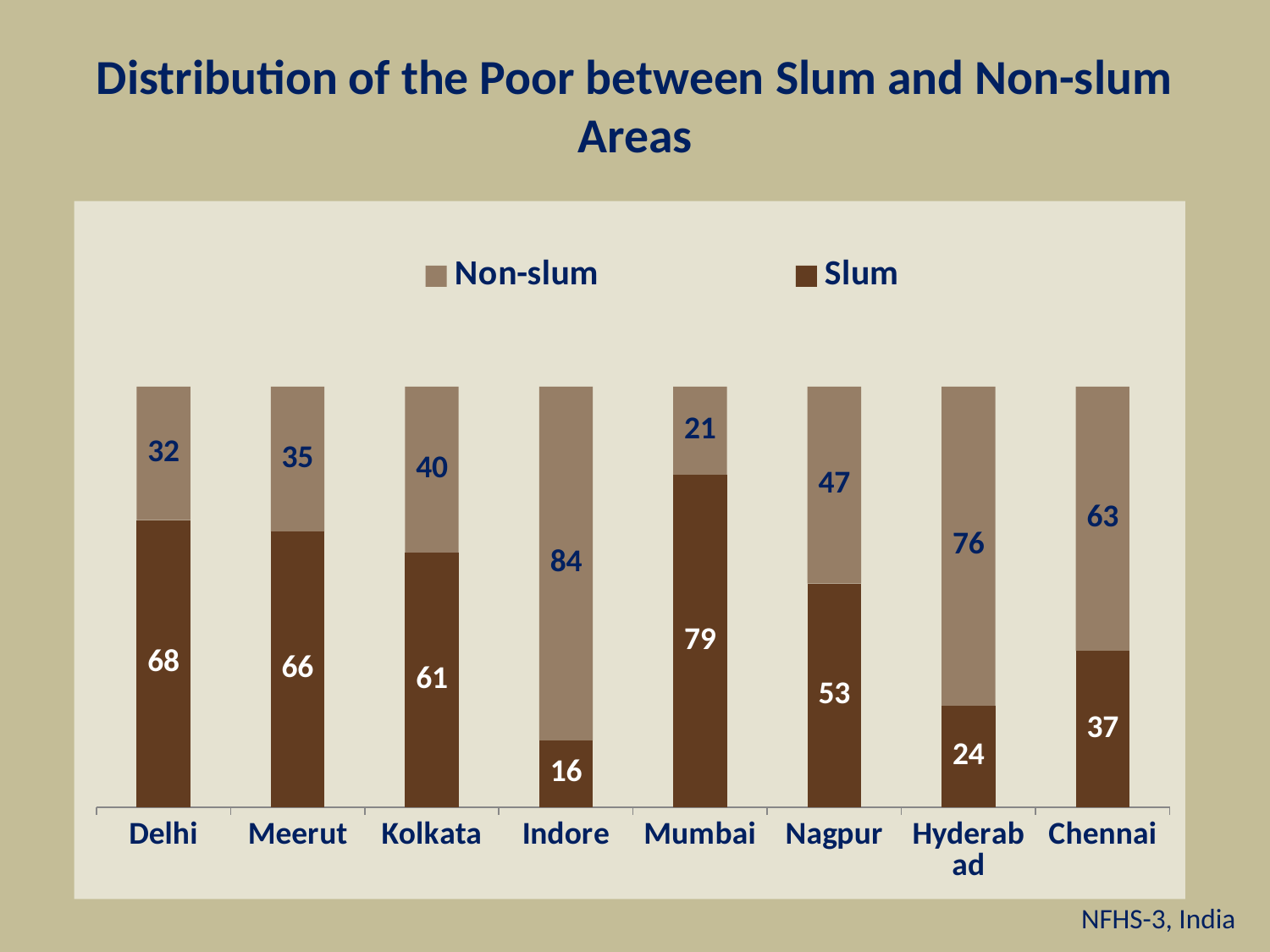
What is the Slum value for Mumbai? 79 How many series does the legend list? 2 What is the Slum value for Indore? 16 What is the difference between the Slum values for Delhi and Chennai? 31 How many cities are shown on the x axis? 8 What kind of chart is shown? Stacked bar chart Which city has the highest Slum value? Mumbai What is the Non-slum value for Hyderabad? 76 What is the title of the chart? Distribution of the Poor between Slum and Non-slum Areas What is the total of the stacked bar for Meerut? 101 Which is larger, the Non-slum value for Nagpur or the Non-slum value for Kolkata? Nagpur Which city has the lowest Non-slum value? Mumbai